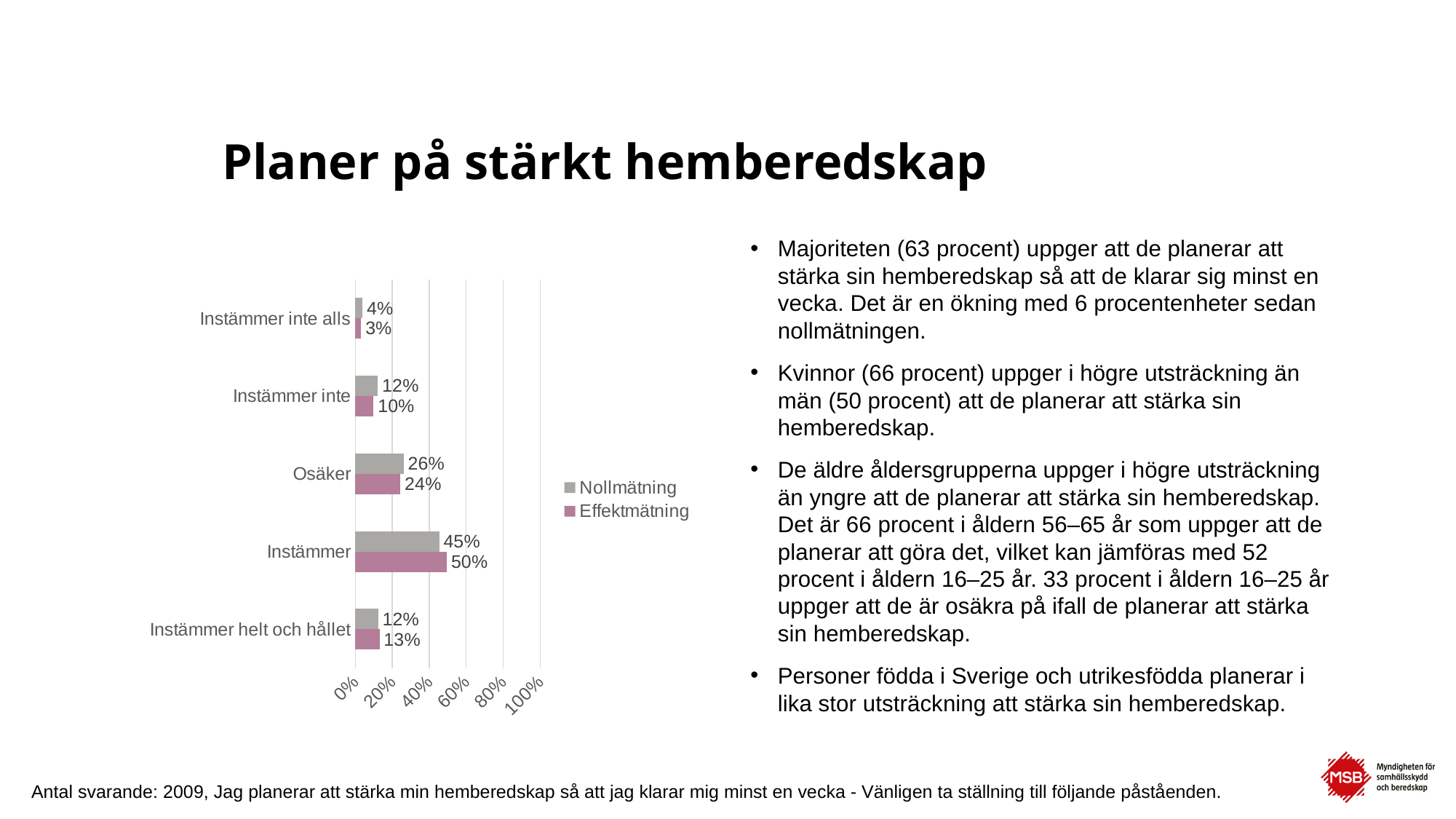
Is the Effektmätning value for Instämmer greater or less than 40%? greater How many categories are shown on the chart? 5 What is the Effektmätning value for Osäker? 24% What is the Effektmätning value for Instämmer helt och hållet? 13% Which category has the lowest Nollmätning value? Instämmer inte alls What is the Nollmätning value for Instämmer? 45% Which category has the highest Effektmätning value? Instämmer How many series does the legend list? 2 What kind of chart is shown on the slide? Bar chart Which series is shown in pink/purple in the legend? Effektmätning What is the difference between the Effektmätning and Nollmätning values for Instämmer? 5% Which is larger for Instämmer inte: the Nollmätning value or the Effektmätning value? Nollmätning